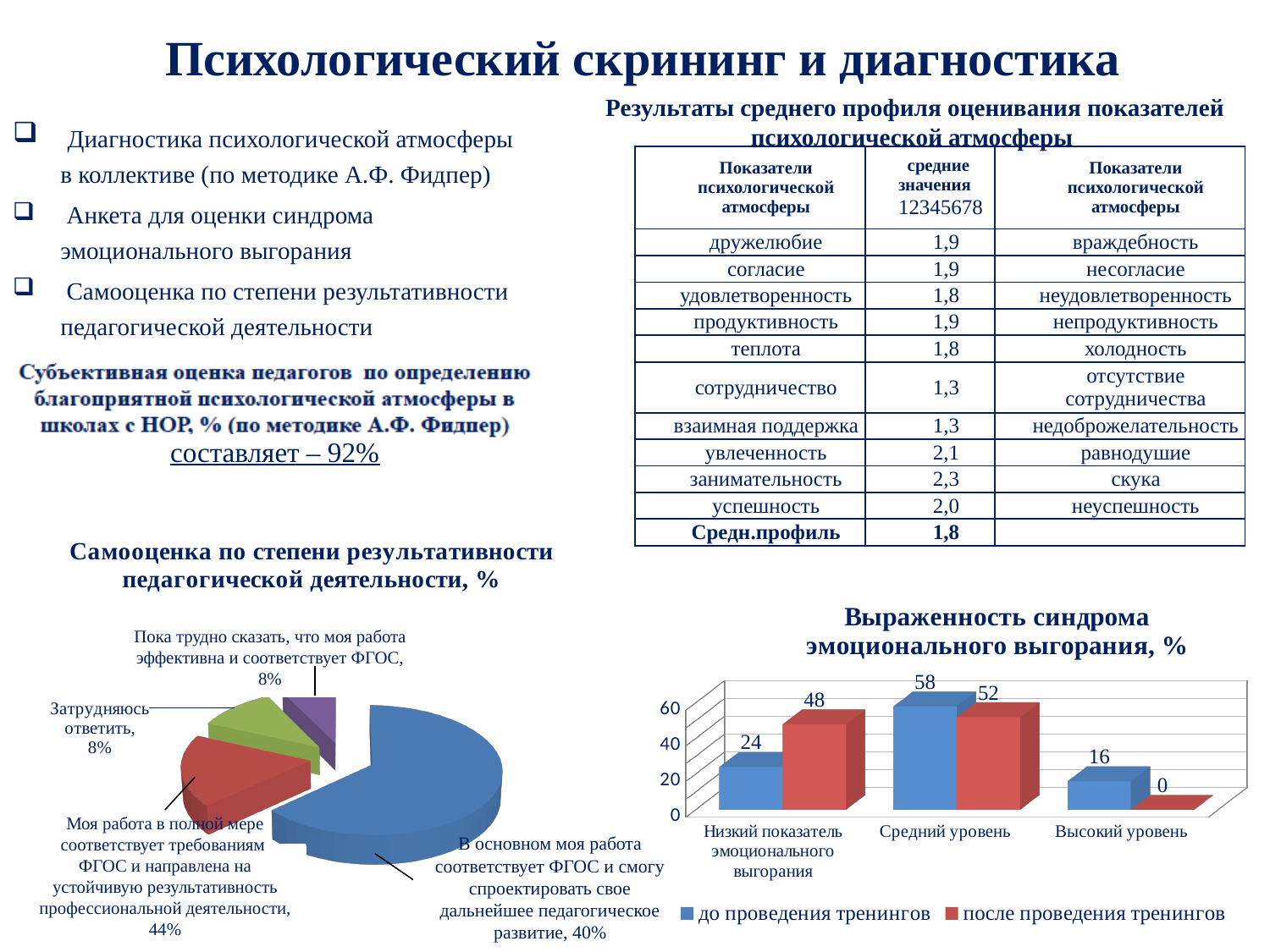
On the chart 'Выраженность синдрома эмоционального выгорания, %', for 'Средний уровень', which is larger: the value 'до проведения тренингов' or 'после проведения тренингов'? до проведения тренингов On the chart 'Выраженность синдрома эмоционального выгорания, %', what is the value for 'Высокий уровень' in the series 'после проведения тренингов'? 0 On the chart 'Выраженность синдрома эмоционального выгорания, %', how many series does the legend list? 2 On the pie chart 'Самооценка по степени результативности педагогической деятельности, %', how many slices are there? 4 On the chart 'Выраженность синдрома эмоционального выгорания, %', what is the value for 'Низкий показатель эмоционального выгорания' in the series 'до проведения тренингов'? 24 On the chart 'Выраженность синдрома эмоционального выгорания, %', what is the difference between the 'после проведения тренингов' and 'до проведения тренингов' values for 'Низкий показатель эмоционального выгорания'? 24 On the chart 'Выраженность синдрома эмоционального выгорания, %', which category has the highest value in the series 'до проведения тренингов'? Средний уровень What kind of chart is 'Самооценка по степени результативности педагогической деятельности, %'? pie chart On the chart 'Выраженность синдрома эмоционального выгорания, %', how many categories are shown on the x axis? 3 What kind of chart is 'Выраженность синдрома эмоционального выгорания, %'? bar chart On the pie chart 'Самооценка по степени результативности педагогической деятельности, %', what share is labelled 'В основном моя работа соответствует ФГОС и смогу спроектировать свое дальнейшее педагогическое развитие'? 40%